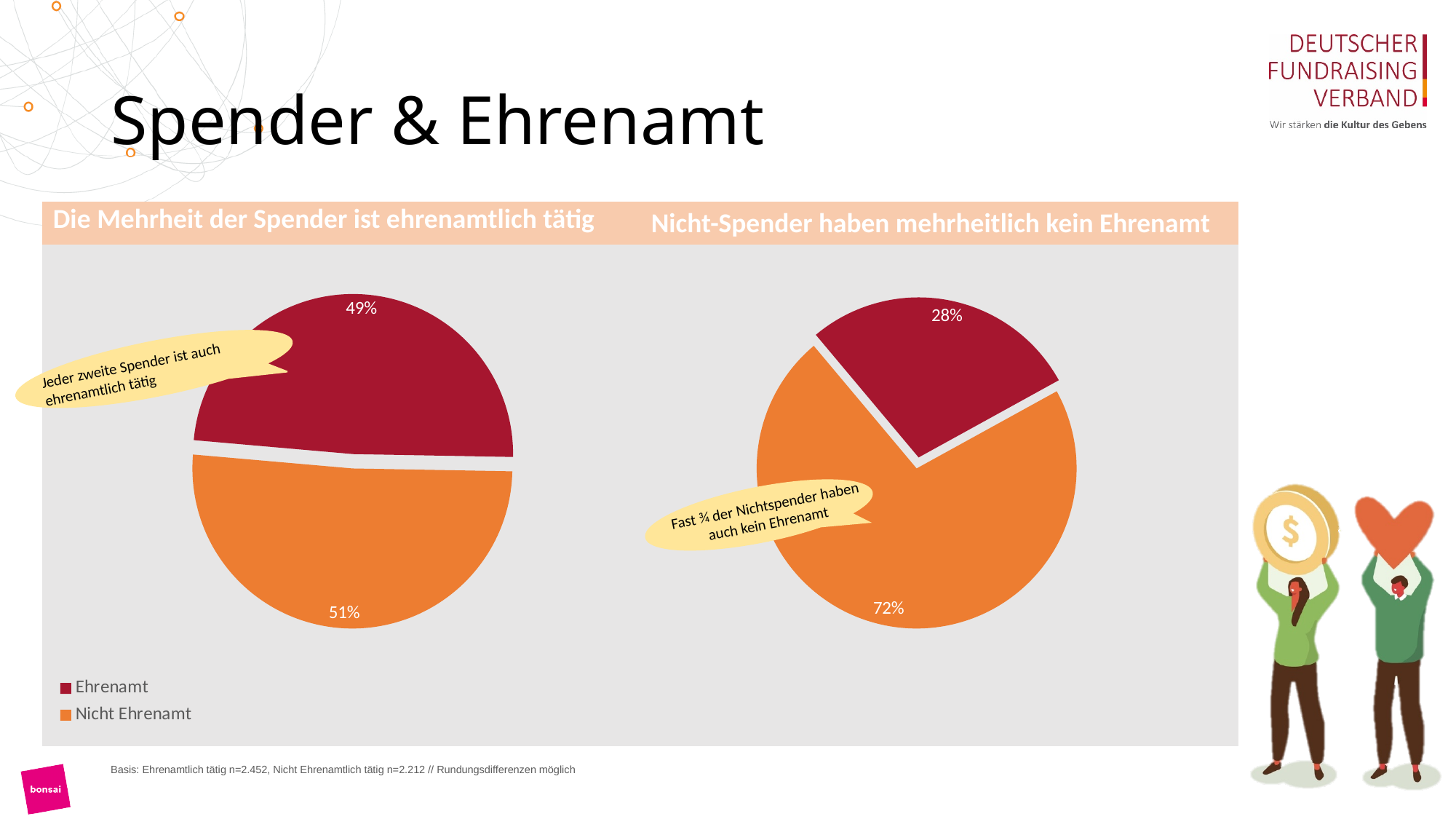
In the left pie chart ('Die Mehrheit der Spender ist ehrenamtlich tätig'), what share is labelled for Nicht Ehrenamt? 51% In the right pie chart ('Nicht-Spender haben mehrheitlich kein Ehrenamt'), which slice is the largest? Nicht Ehrenamt In the right pie chart ('Nicht-Spender haben mehrheitlich kein Ehrenamt'), what share is labelled for Nicht Ehrenamt? 72% In the right pie chart ('Nicht-Spender haben mehrheitlich kein Ehrenamt'), which slice is the smallest? Ehrenamt How many slices does the left pie chart ('Die Mehrheit der Spender ist ehrenamtlich tätig') have? 2 In the right pie chart ('Nicht-Spender haben mehrheitlich kein Ehrenamt'), what is the difference in percentage points between Nicht Ehrenamt and Ehrenamt? 44 percentage points How many entries does the legend list? 2 Which chart has the larger Ehrenamt share: the left pie chart or the right pie chart? The left pie chart In the left pie chart ('Die Mehrheit der Spender ist ehrenamtlich tätig'), what share is labelled for Ehrenamt? 49% In the right pie chart ('Nicht-Spender haben mehrheitlich kein Ehrenamt'), what share is labelled for Ehrenamt? 28% In the left pie chart ('Die Mehrheit der Spender ist ehrenamtlich tätig'), what is the difference in percentage points between Nicht Ehrenamt and Ehrenamt? 2 percentage points What type of chart is used on this slide? Pie chart